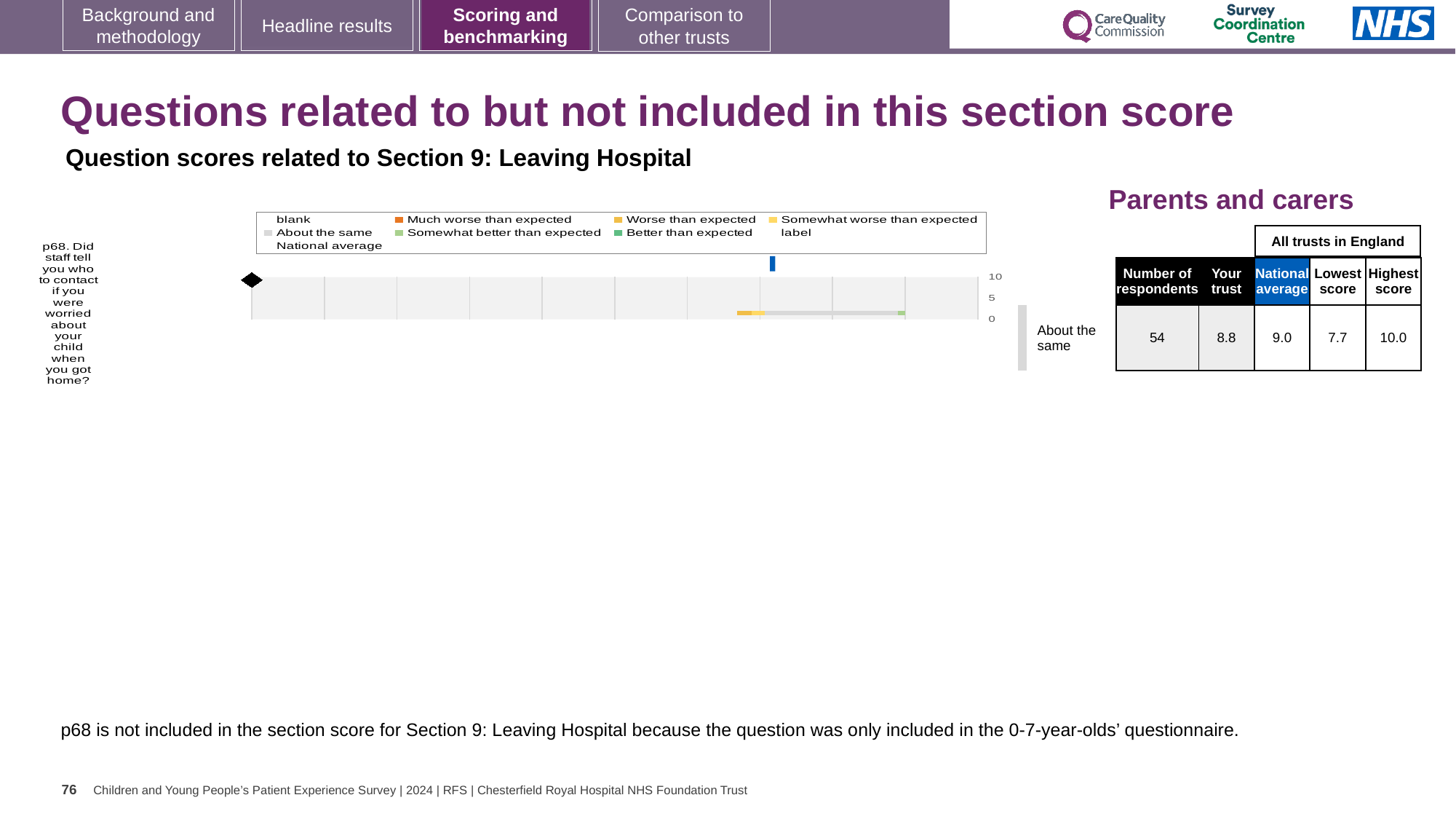
How many respondents answered p68? 54 What kind of chart is shown on the slide for question p68? bar chart Which question is plotted in the chart? p68. Did staff tell you who to contact if you were worried about your child when you got home? What is the Lowest score among all trusts in England for p68? 7.7 What benchmark category is shown next to the chart for p68? About the same How many survey questions are plotted in the chart? 1 Which is larger for p68, the 'Your trust' score or the National average? National average What is the difference between the Highest score and the Lowest score for p68? 2.3 What is the 'Your trust' score for p68? 8.8 Is the 'Your trust' score for p68 greater or less than 5? greater What is the National average score for p68? 9.0 What is the Highest score among all trusts in England for p68? 10.0